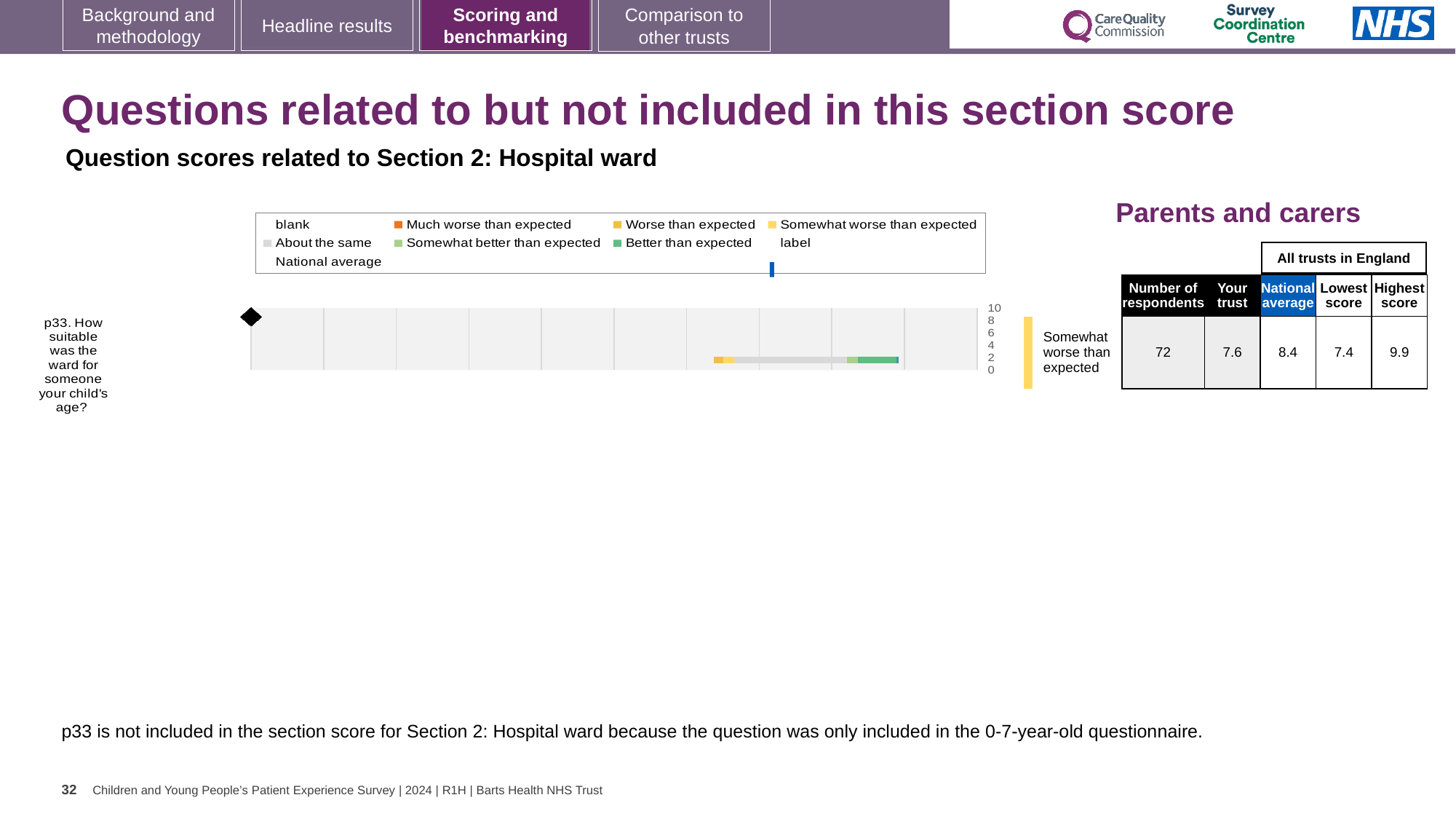
What benchmark category is shown for p33 next to the chart? Somewhat worse than expected Is the 'Your trust' score for p33 greater or less than 8? less What kind of chart is shown on the slide? bar chart What is the subtitle above the chart describing the question scores? Question scores related to Section 2: Hospital ward How many entries does the chart legend list? 9 Which question is plotted in the chart? p33. How suitable was the ward for someone your child's age? In the table, what is the national average score for p33? 8.4 Which is larger for p33: the 'Your trust' score or the national average? National average In the table, how many respondents answered p33? 72 In the table, what is the difference between the highest score and the lowest score for p33? 2.5 In the table, what is the 'Your trust' score for p33? 7.6 How many questions (categories) are plotted in the chart? 1